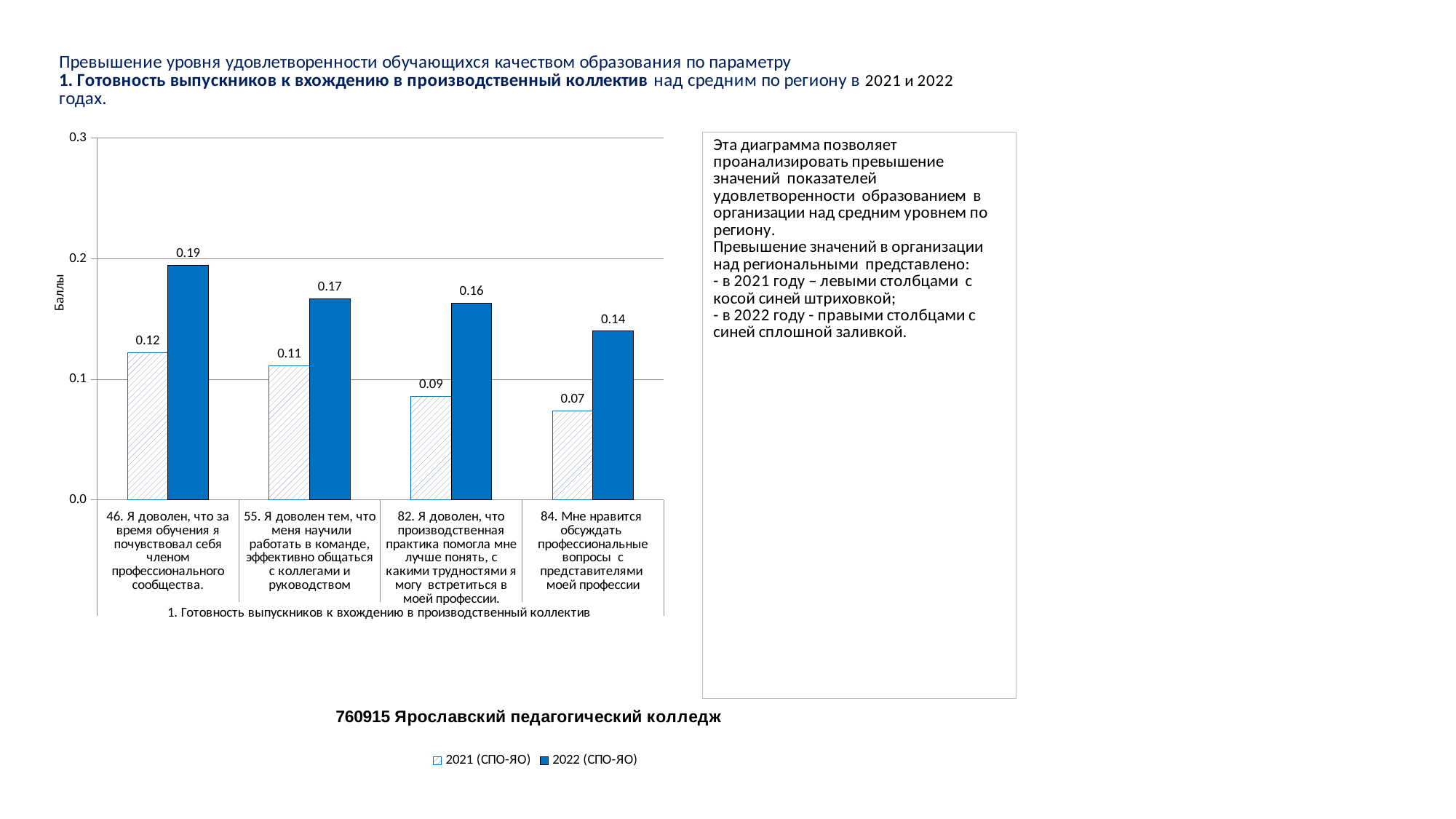
Which category has the highest 2022 (СПО-ЯО) value? 46. Я доволен, что за время обучения я почувствовал себя членом профессионального сообщества. How many series does the legend list? 2 What type of chart is shown on the slide? bar chart Which is larger for category 55: the 2021 (СПО-ЯО) value or the 2022 (СПО-ЯО) value? 2022 (СПО-ЯО) Do the 2022 (СПО-ЯО) values rise or fall from left to right along the x axis? fall What is the 2021 (СПО-ЯО) value for category 84 (Мне нравится обсуждать профессиональные вопросы с представителями моей профессии)? 0.07 What is the 2022 (СПО-ЯО) value for category 46 (Я доволен, что за время обучения я почувствовал себя членом профессионального сообщества)? 0.19 Which category has the lowest 2021 (СПО-ЯО) value? 84. Мне нравится обсуждать профессиональные вопросы с представителями моей профессии What is the 2021 (СПО-ЯО) value for category 55 (Я доволен тем, что меня научили работать в команде)? 0.11 How many categories are shown on the x axis? 4 What is the difference between the 2022 and 2021 values for category 82 (производственная практика помогла мне лучше понять)? 0.07 What is the label of the y axis? Баллы